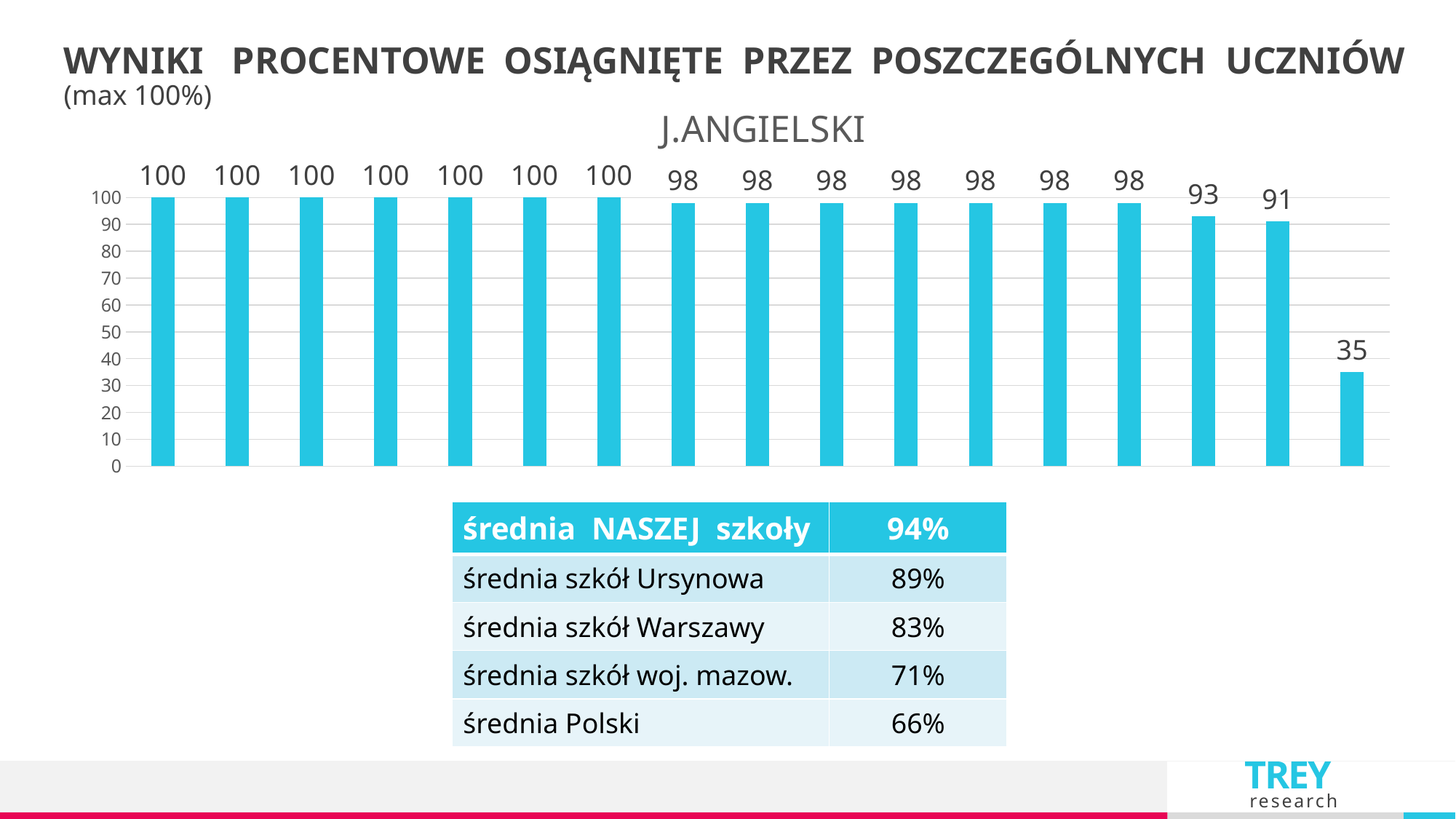
What is the value of the third bar from the right? 93 Do the bar values rise or fall from left to right across the chart? fall What is the difference between the highest bar value and the lowest bar value? 65 What type of chart is shown on the slide? bar chart How many bars have a value of 98? 7 What is the title of the chart? J.ANGIELSKI How many bars are plotted in the chart? 17 What is the highest value shown in the chart? 100 How many bars have a value of 100? 7 What is the lowest value shown in the chart? 35 What is the value of the rightmost bar in the chart? 35 What is the value of the second bar from the right? 91